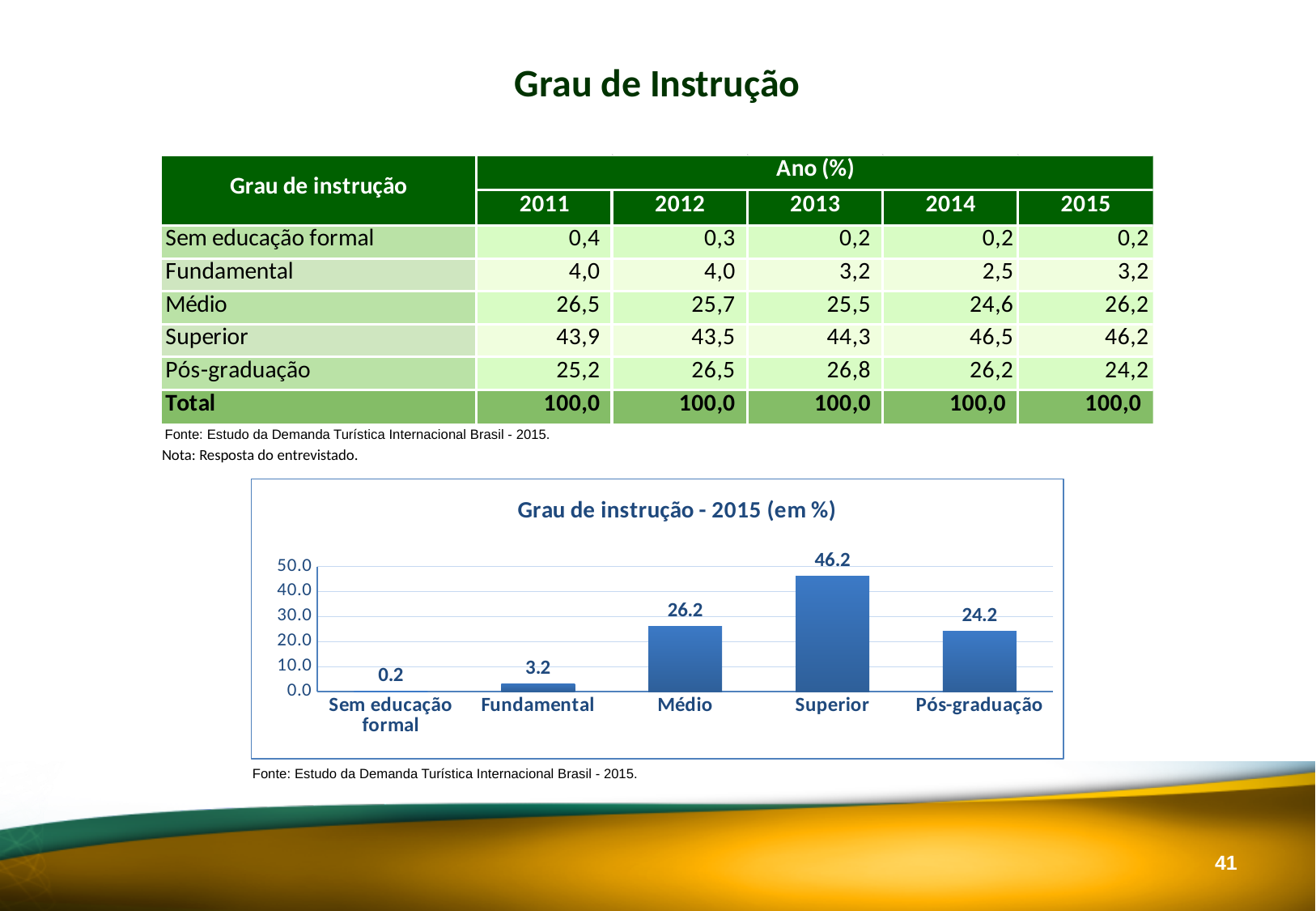
What is the value for Pós-graduação in the chart? 24.2 What is the value for Superior in the chart? 46.2 What is the value for Fundamental in the chart? 3.2 What kind of chart is shown on the slide? bar chart What is the title of the chart? Grau de instrução - 2015 (em %) Which category has the highest value in the chart? Superior Is the value for Superior greater or less than 40.0? greater Which is larger, the value for Médio or the value for Pós-graduação? Médio Which category has the lowest value in the chart? Sem educação formal What is the difference between the values for Superior and Médio? 20.0 How many categories are shown in the chart? 5 What is the difference between the values for Médio and Pós-graduação? 2.0